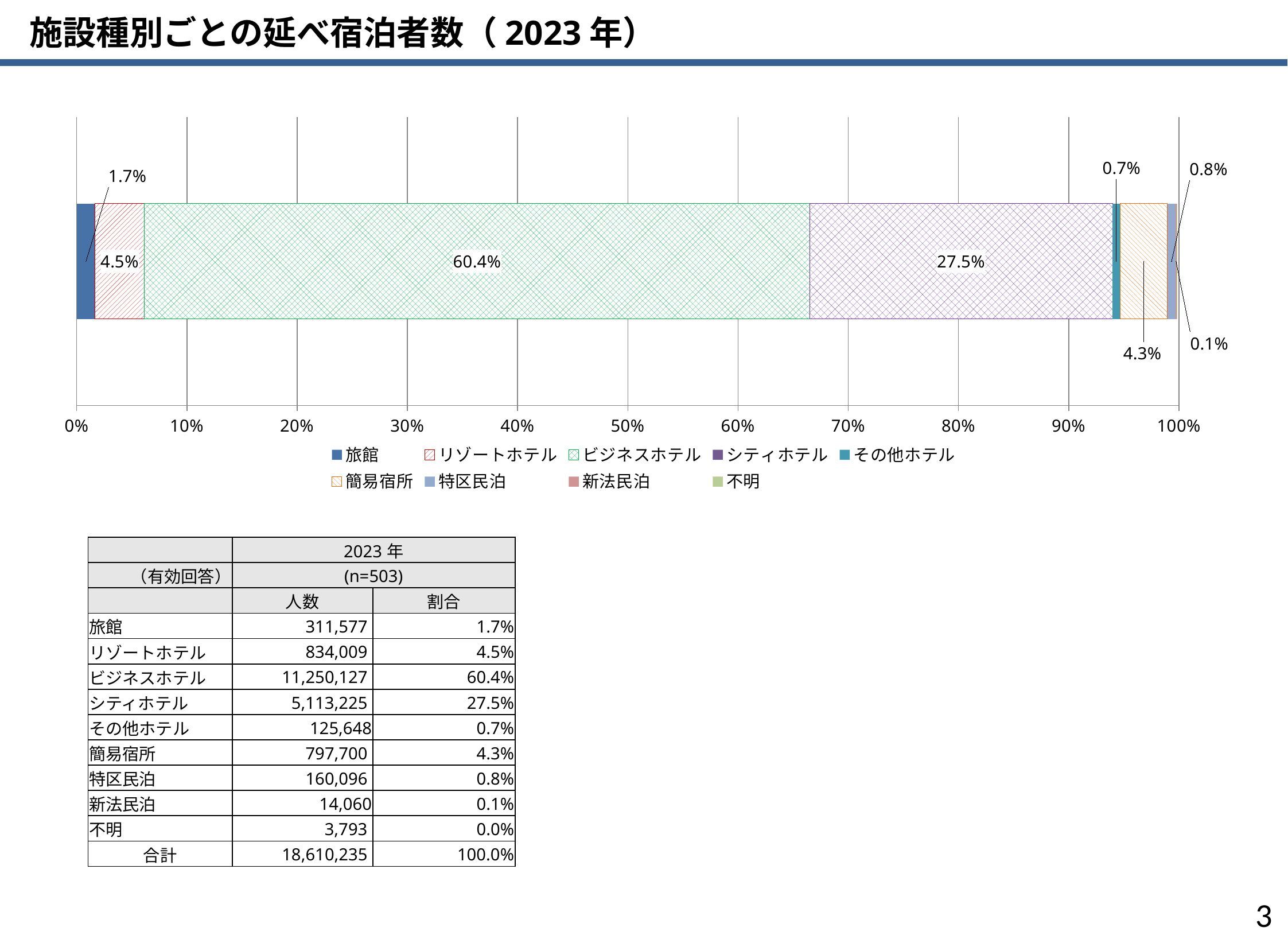
Which is larger, the value for リゾートホテル or the value for 簡易宿所? リゾートホテル What is the title of the slide containing the chart? 施設種別ごとの延べ宿泊者数（2023年） What is the value shown for 簡易宿所 in the chart? 4.3% What is the difference between the values for 特区民泊 and その他ホテル? 0.1% What is the value shown for 旅館 in the chart? 1.7% Which series has the largest share in the chart? ビジネスホテル What is the value shown for シティホテル in the chart? 27.5% What is the difference between the values for ビジネスホテル and シティホテル? 32.9% How many series does the chart legend list? 9 What is the value shown for ビジネスホテル in the chart? 60.4% What is the value shown for リゾートホテル in the chart? 4.5% What kind of chart is shown on the slide? stacked bar chart